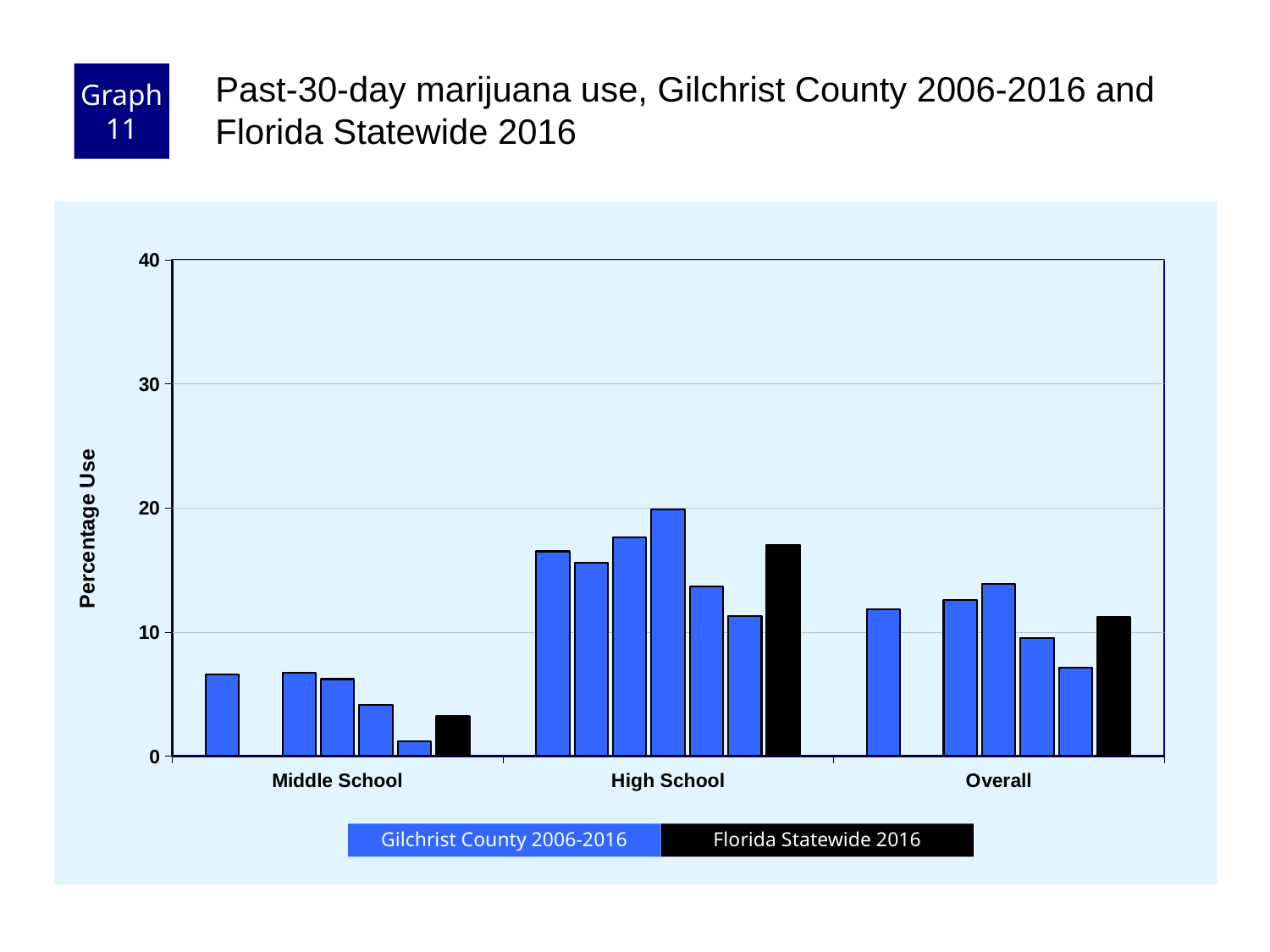
Which is larger, the Florida Statewide 2016 value for Middle School or for High School? High School How many categories are shown on the x axis? 3 What kind of chart is shown on the slide? bar chart Is the Florida Statewide 2016 value for High School greater or less than 10? greater How many series does the legend list? 2 Is the Florida Statewide 2016 value for Middle School greater or less than 10? less Is the Florida Statewide 2016 value for Overall greater or less than 20? less Which category has the shortest bar in the chart? Middle School What is the label on the y axis? Percentage Use Which colour represents Florida Statewide 2016 in the legend? black Which category has the tallest bar in the chart? High School